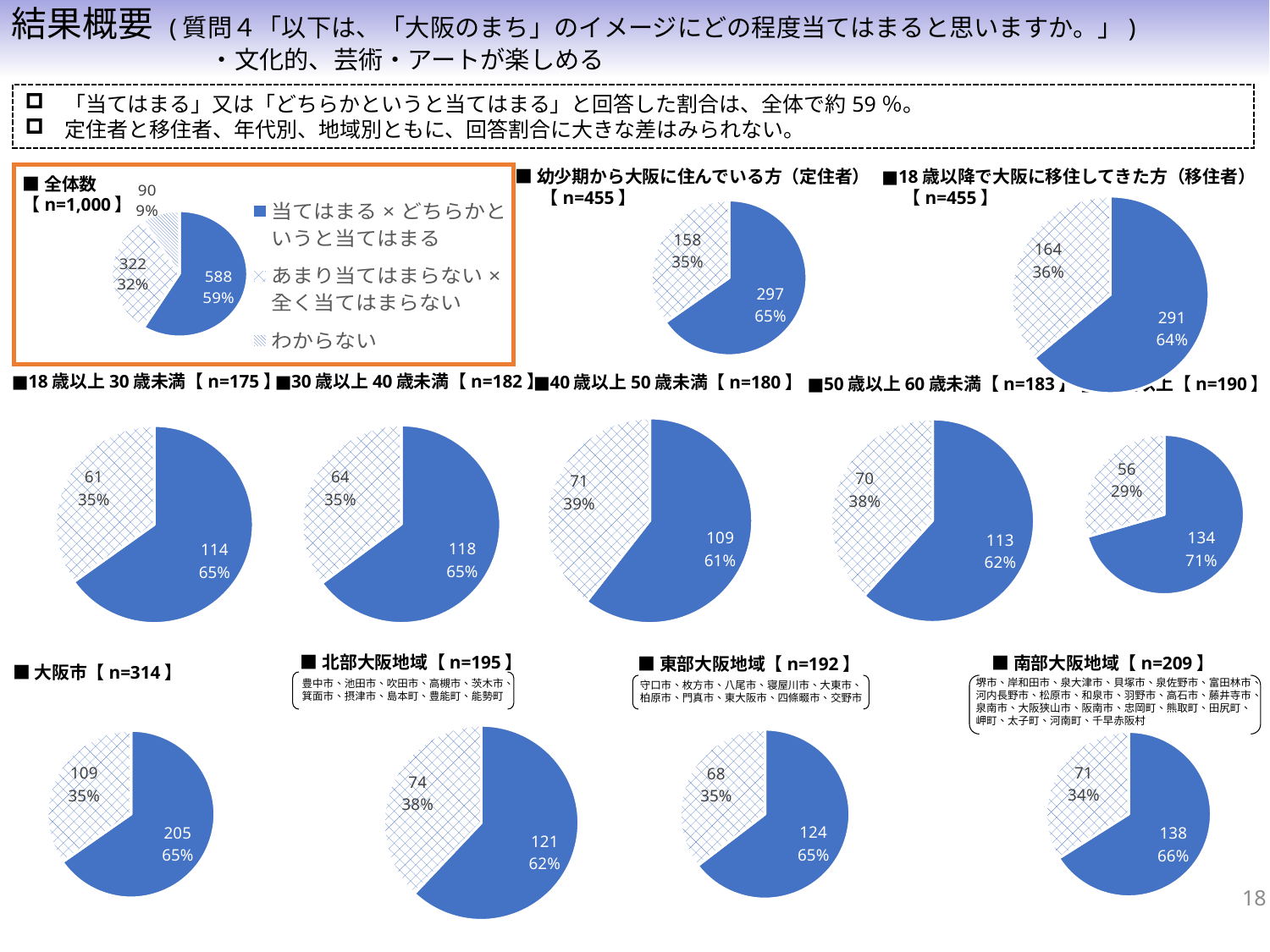
「北部大阪地域【n=195】」の円グラフと「南部大阪地域【n=209】」の円グラフでは、大きい方の区分の割合はどちらが高いですか。 南部大阪地域 「40歳以上50歳未満【n=180】」の円グラフで、大きい方の区分の値はいくつですか。 109 「全体数【n=1,000】」の円グラフで、「当てはまる × どちらかというと当てはまる」の値はいくつですか。 588 このスライドのグラフはどの種類のグラフですか。 円グラフ 「全体数【n=1,000】」の円グラフの凡例には、いくつの項目がありますか。 3 「大阪市【n=314】」の円グラフで、大きい方の区分の値はいくつですか。 205 「18歳以降で大阪に移住してきた方（移住者）【n=455】」の円グラフで、小さい方の区分の値はいくつですか。 164 「幼少期から大阪に住んでいる方（定住者）【n=455】」の円グラフで、大きい方の区分の割合は何%ですか。 65% 「全体数【n=1,000】」の円グラフで、「わからない」の割合は何%ですか。 9% 「50歳以上60歳未満【n=183】」の円グラフで、小さい方の区分の割合は何%ですか。 38% 「東部大阪地域【n=192】」の円グラフで、小さい方の区分の値はいくつですか。 68 「全体数【n=1,000】」の円グラフで、「当てはまる × どちらかというと当てはまる」と「あまり当てはまらない × 全く当てはまらない」の差はいくつですか。 266